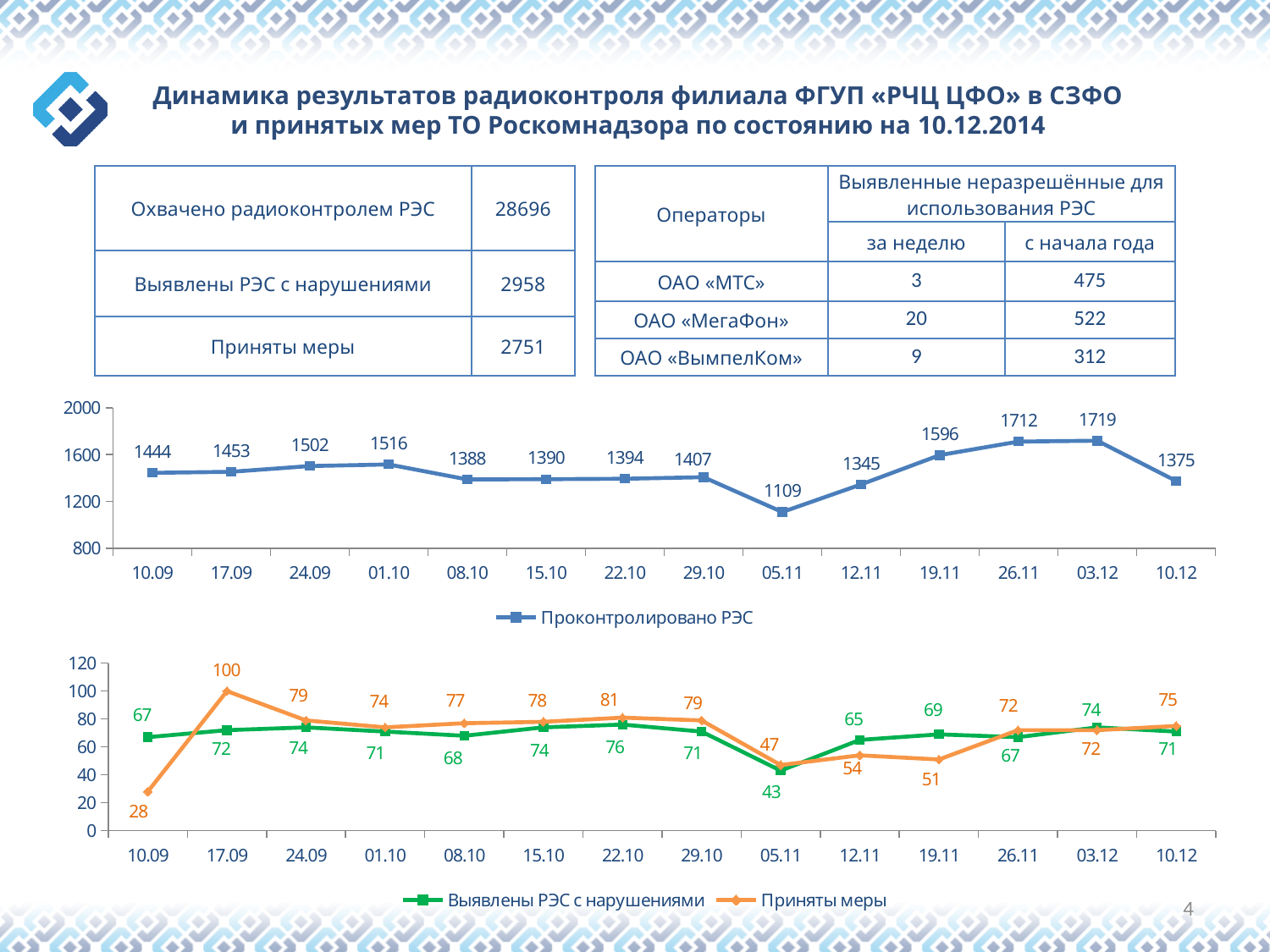
In the top chart (Проконтролировано РЭС), which date has the lowest value? 05.11 What type of chart is the top chart? Line chart In the bottom chart, what is the difference between Приняты меры and Выявлены РЭС с нарушениями for 10.09? 39 In the bottom chart, what is the value of Приняты меры for 17.09? 100 In the bottom chart, which is larger for 19.11: Выявлены РЭС с нарушениями or Приняты меры? Выявлены РЭС с нарушениями In the top chart (Проконтролировано РЭС), how many data points are plotted? 14 In the top chart (Проконтролировано РЭС), is the value for 26.11 greater or less than 1600? greater How many series does the legend of the bottom chart list? 2 In the top chart (Проконтролировано РЭС), what is the value for 05.11? 1109 In the top chart (Проконтролировано РЭС), what is the difference between the values for 03.12 and 10.12? 344 In the top chart (Проконтролировано РЭС), which date has the highest value? 03.12 In the bottom chart, what is the value of Выявлены РЭС с нарушениями for 05.11? 43